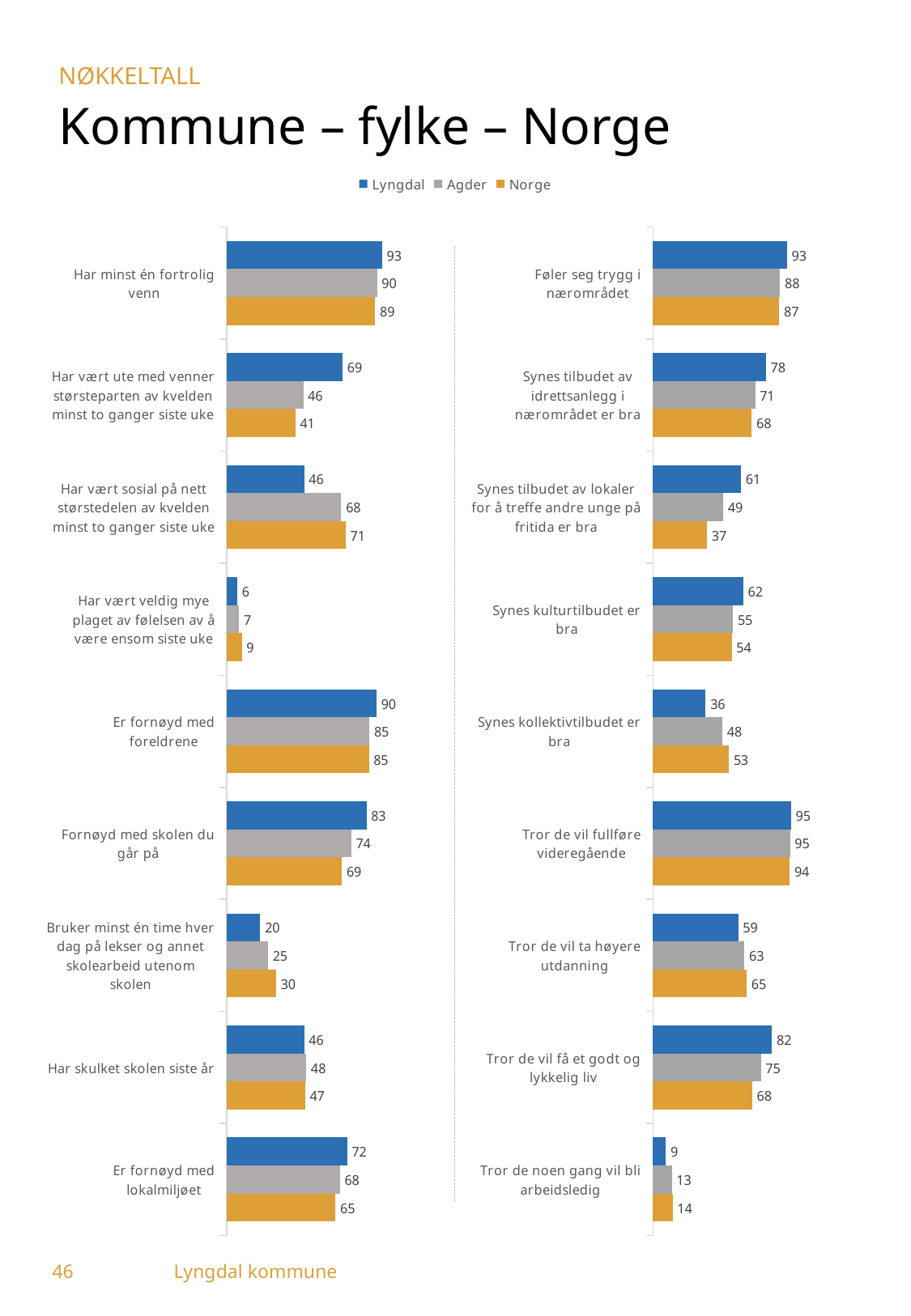
In the left chart, what is the Lyngdal value for "Har vært ute med venner størsteparten av kvelden minst to ganger siste uke"? 69 Which series is shown in orange in the legend? Norge In the right chart, what is the Norge value for "Synes tilbudet av lokaler for å treffe andre unge på fritida er bra"? 37 What kind of chart is used on this slide? Bar chart How many categories does the left chart show? 9 In the right chart, which category has the lowest Lyngdal value? Tror de noen gang vil bli arbeidsledig How many series does the legend list? 3 In the left chart, what is the Agder value for "Har vært sosial på nett størstedelen av kvelden minst to ganger siste uke"? 68 In the right chart, which category has the highest Lyngdal value? Tror de vil fullføre videregående In the right chart, what is the difference between the Lyngdal and Agder values for "Tror de vil få et godt og lykkelig liv"? 7 In the left chart, what is the difference between the Lyngdal and Norge values for "Har vært ute med venner størsteparten av kvelden minst to ganger siste uke"? 28 In the right chart, for "Synes kollektivtilbudet er bra", which is larger: the Lyngdal value or the Norge value? Norge